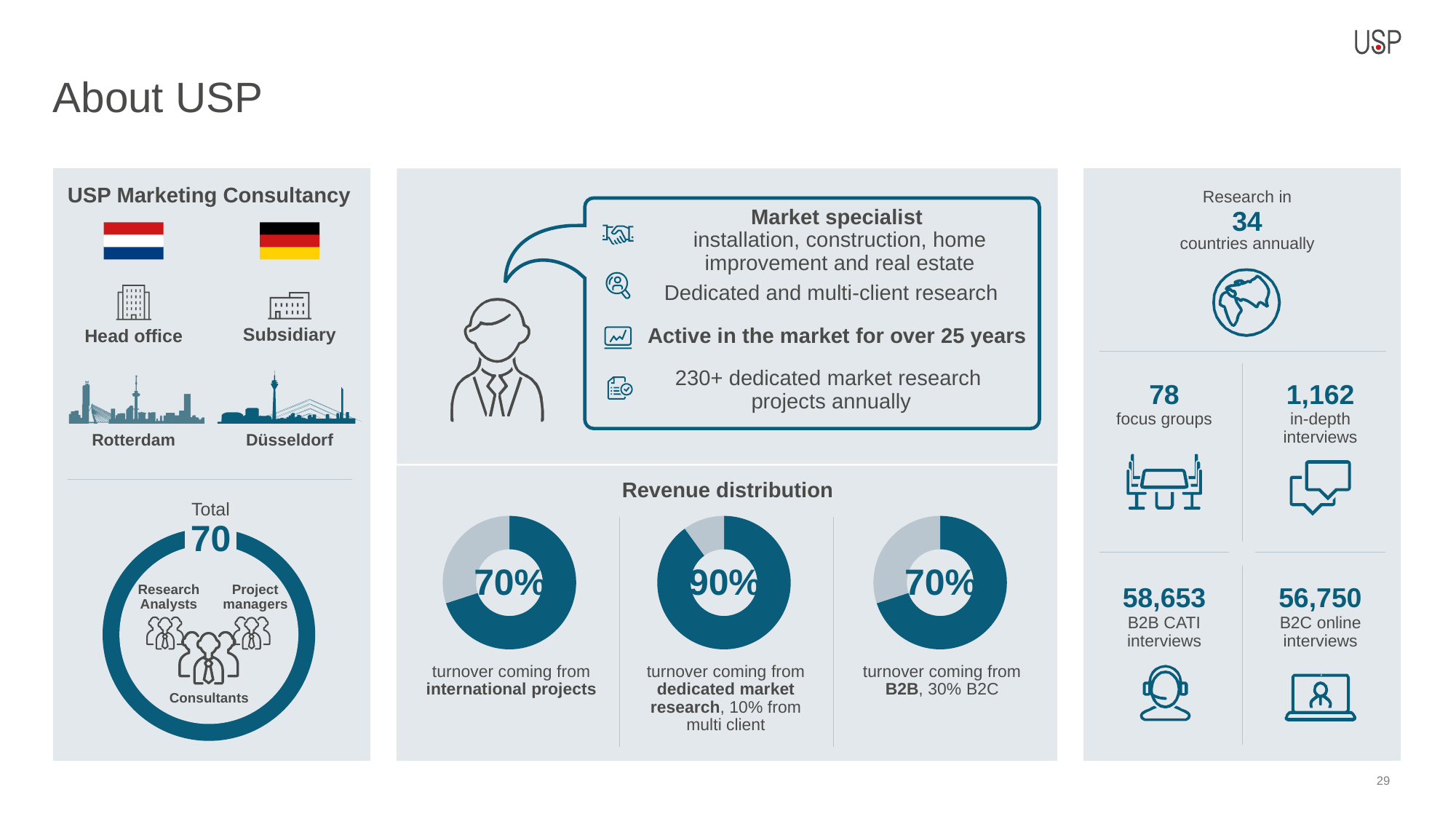
In the Revenue distribution charts, what percentage of turnover comes from international projects? 70% In the Revenue distribution charts, what percentage of turnover comes from B2B? 70% In the Revenue distribution charts, which is larger: the share from dedicated market research or the share from international projects? dedicated market research How many donut charts are shown under the Revenue distribution heading? 3 In the middle Revenue distribution chart, what percentage of turnover comes from multi client work? 10% In the Revenue distribution charts, what is the difference between the dedicated market research share and the international projects share? 20 percentage points In the Revenue distribution charts, what percentage of turnover comes from dedicated market research? 90% In the right-hand Revenue distribution chart, what share of turnover comes from B2C? 30% Among the three Revenue distribution charts, which category has the highest highlighted percentage? dedicated market research In the right-hand Revenue distribution chart, what is the difference between the B2B share and the B2C share? 40 percentage points What is the heading above the three donut charts in the middle panel? Revenue distribution What kind of chart is used for the Revenue distribution figures? pie chart (donut)